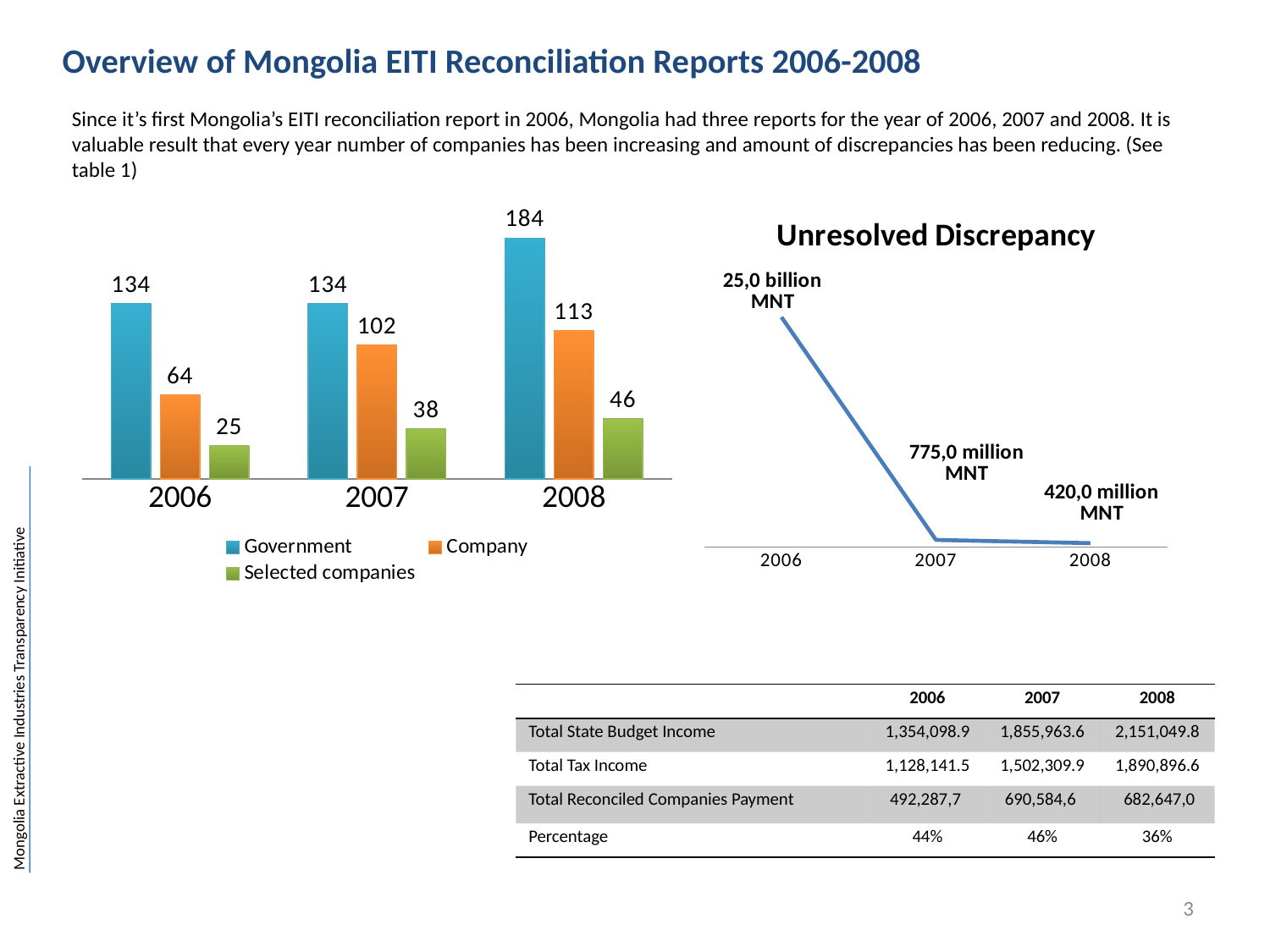
In the bar chart on the left, what is the value for Company in 2007? 102 In the bar chart on the left, which year has the highest Government value? 2008 What kind of chart is the 'Unresolved Discrepancy' chart? line chart In the bar chart on the left, which year has the lowest Selected companies value? 2006 In the 'Unresolved Discrepancy' chart, what is the value for 2006? 25,0 billion MNT In the bar chart on the left, is the Company value larger in 2007 or in 2006? 2007 In the bar chart on the left, what is the value for Selected companies in 2006? 25 In the bar chart on the left, what is the value for Government in 2008? 184 In the 'Unresolved Discrepancy' chart, do the values rise or fall from 2006 to 2008? fall How many series does the legend of the bar chart on the left list? 3 In the bar chart on the left, what is the difference between the Government and Company values in 2008? 71 In the 'Unresolved Discrepancy' chart, what is the value for 2008? 420,0 million MNT